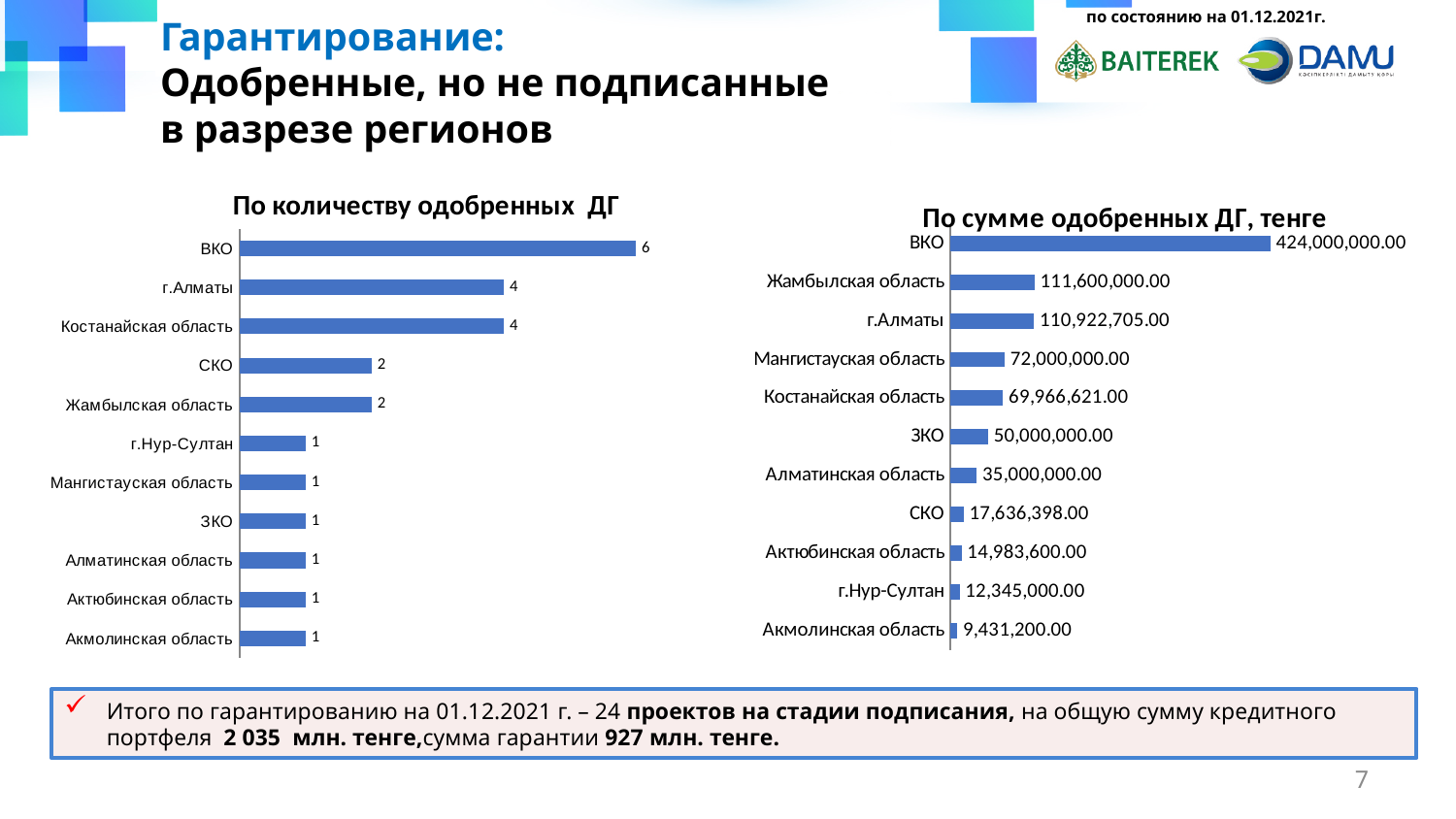
What is the title of the chart on the left side of the slide? По количеству одобренных ДГ In the chart 'По количеству одобренных ДГ', what is the difference between the values for ВКО and СКО? 4 In the chart 'По сумме одобренных ДГ, тенге', what is the value for Жамбылская область? 111,600,000.00 In the chart 'По количеству одобренных ДГ', what is the value for Костанайская область? 4 In the chart 'По сумме одобренных ДГ, тенге', what is the difference between the values for ВКО and Жамбылская область? 312,400,000.00 In the chart 'По сумме одобренных ДГ, тенге', what is the value for СКО? 17,636,398.00 In the chart 'По количеству одобренных ДГ', how many categories are shown? 11 In the chart 'По сумме одобренных ДГ, тенге', which is larger: the value for Мангистауская область or the value for ЗКО? Мангистауская область In the chart 'По сумме одобренных ДГ, тенге', which region has the lowest value? Акмолинская область In the chart 'По количеству одобренных ДГ', what is the value for ВКО? 6 In the chart 'По количеству одобренных ДГ', which region has the highest value? ВКО What type of chart is 'По сумме одобренных ДГ, тенге'? Bar chart